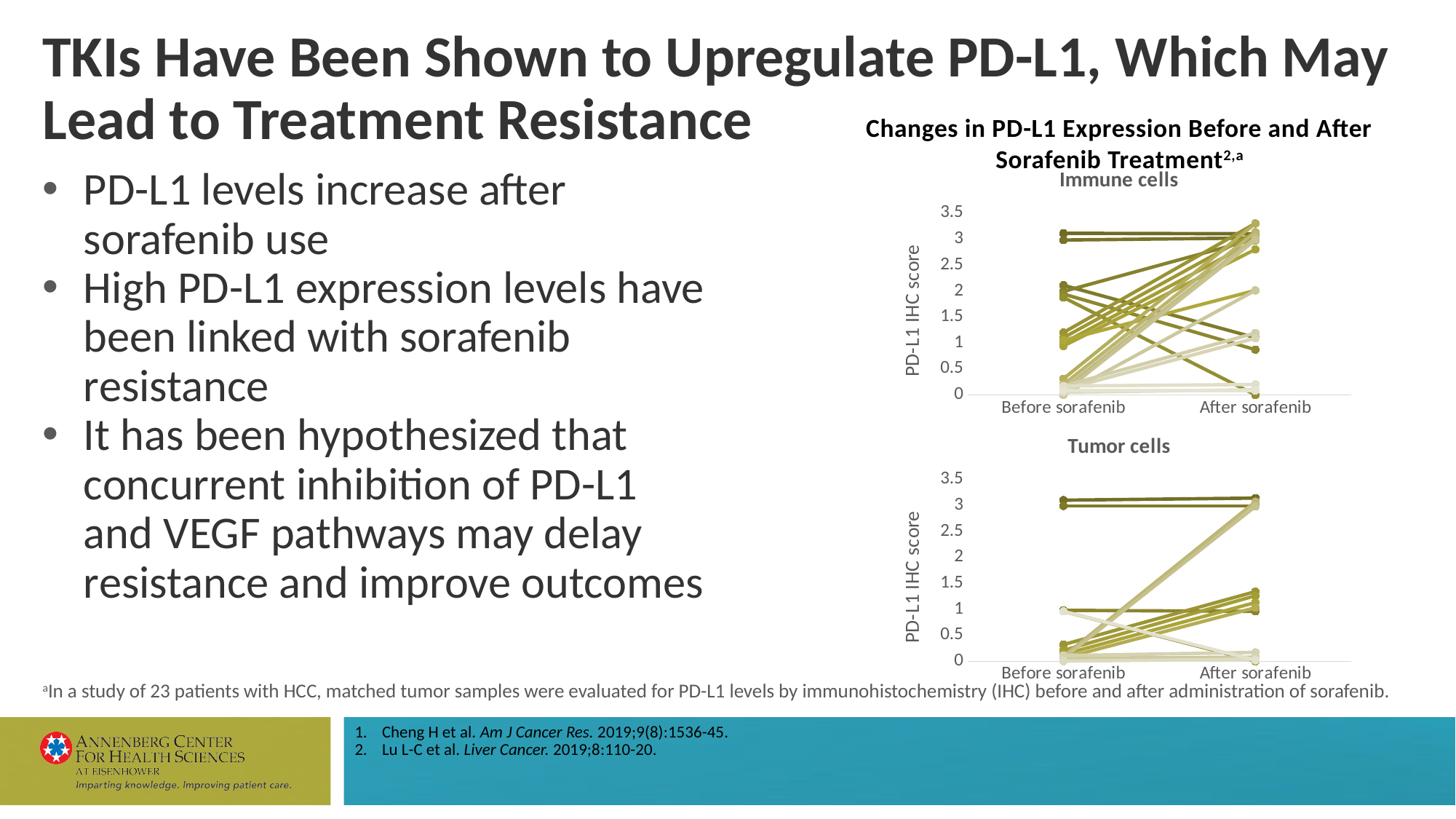
In the Immune cells chart, is the highest value after sorafenib greater or less than 2.5? greater What is the y-axis title of the Tumor cells chart? PD-L1 IHC score How many categories are shown on the x axis of the Tumor cells chart? 2 What is the highest tick value on the y axis of the Immune cells chart? 3.5 What are the two x-axis categories on the Immune cells chart? Before sorafenib and After sorafenib What kind of chart is the Tumor cells chart? line chart In the Tumor cells chart, is the highest value before sorafenib greater or less than 2.5? greater In the Tumor cells chart, is the lowest value after sorafenib greater or less than 0.5? less What kind of chart is the Immune cells chart? line chart In the Immune cells chart, do most lines rise or fall from Before sorafenib to After sorafenib? rise